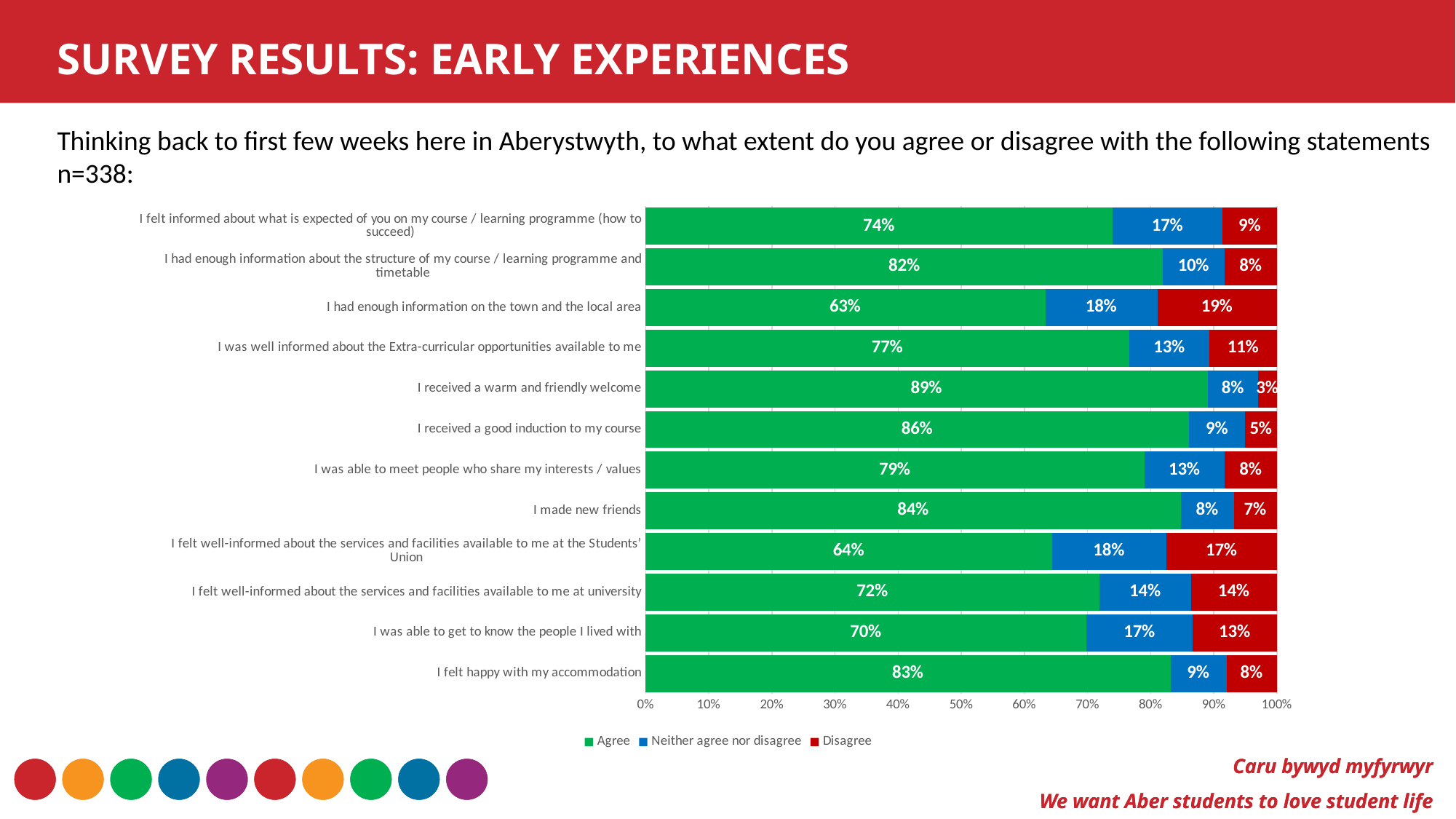
What is the difference between the Agree percentages for "I made new friends" and "I felt well-informed about the services and facilities available to me at the Students' Union"? 20% Which colour represents the Disagree series in the chart? Red How many series does the legend list? 3 Which statement has the lowest Agree percentage? I had enough information on the town and the local area What type of chart is shown on the slide? Stacked bar chart Which statement has the lowest Disagree percentage? I received a warm and friendly welcome How many statements are shown in the chart? 12 What is the Neither agree nor disagree value for "I was able to get to know the people I lived with"? 17% Which has a higher Agree percentage: "I received a good induction to my course" or "I felt happy with my accommodation"? I received a good induction to my course What percentage of respondents agreed with "I received a warm and friendly welcome"? 89% What is the Disagree value for "I had enough information on the town and the local area"? 19% Which statement has the highest Agree percentage? I received a warm and friendly welcome